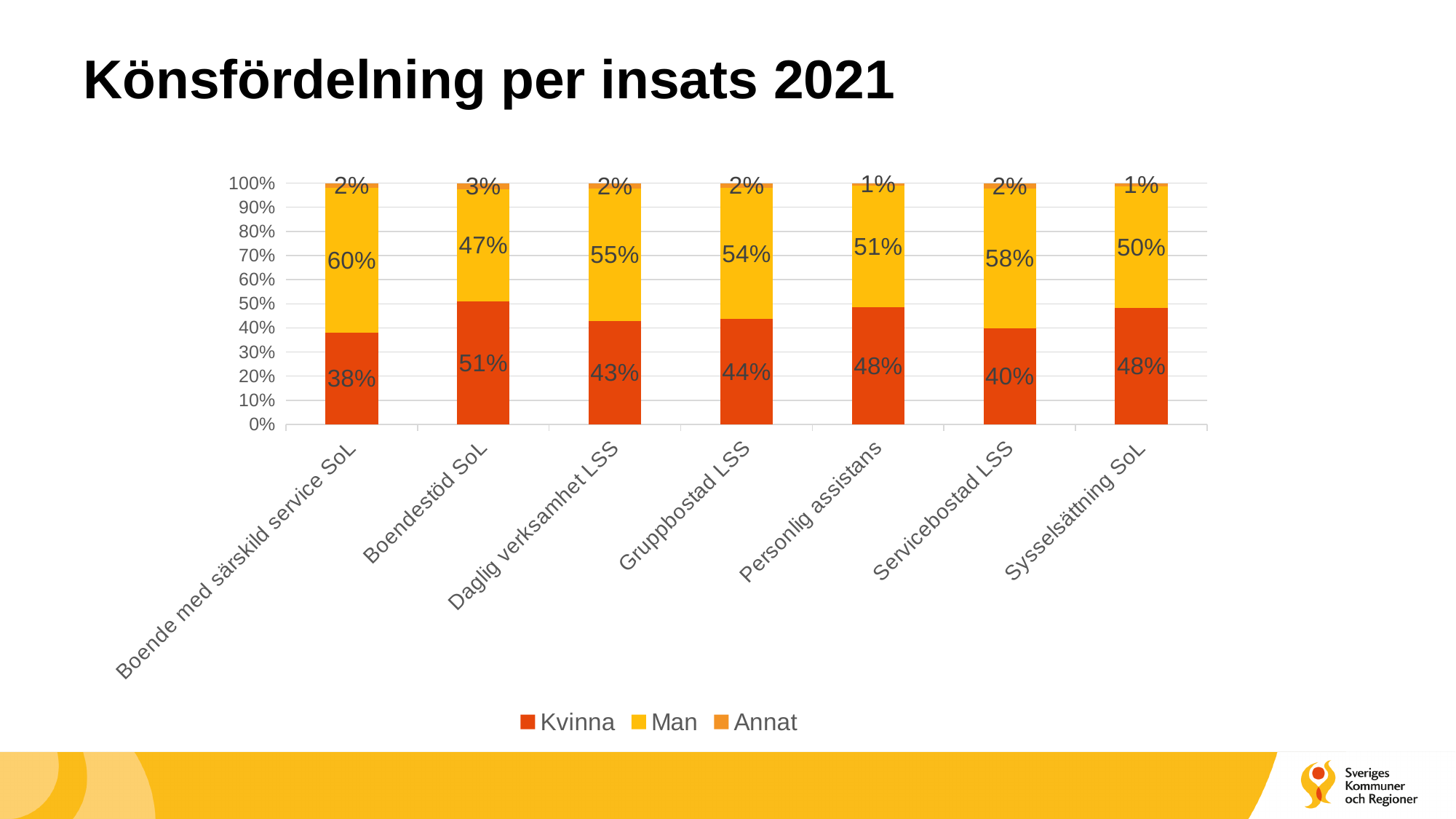
What is the Kvinna value for Boende med särskild service SoL? 38% Which category has the highest Kvinna value? Boendestöd SoL What is the difference between the Man and Kvinna values for Daglig verksamhet LSS? 12% How many categories are shown on the x axis? 7 Which category has the highest Man value? Boende med särskild service SoL What kind of chart is shown on the slide? Stacked bar chart Which is larger for Gruppbostad LSS, the Kvinna value or the Man value? Man Which category has the lowest Kvinna value? Boende med särskild service SoL What is the title of the slide? Könsfördelning per insats 2021 What is the Annat value for Boendestöd SoL? 3% How many series does the legend list? 3 What is the Man value for Servicebostad LSS? 58%